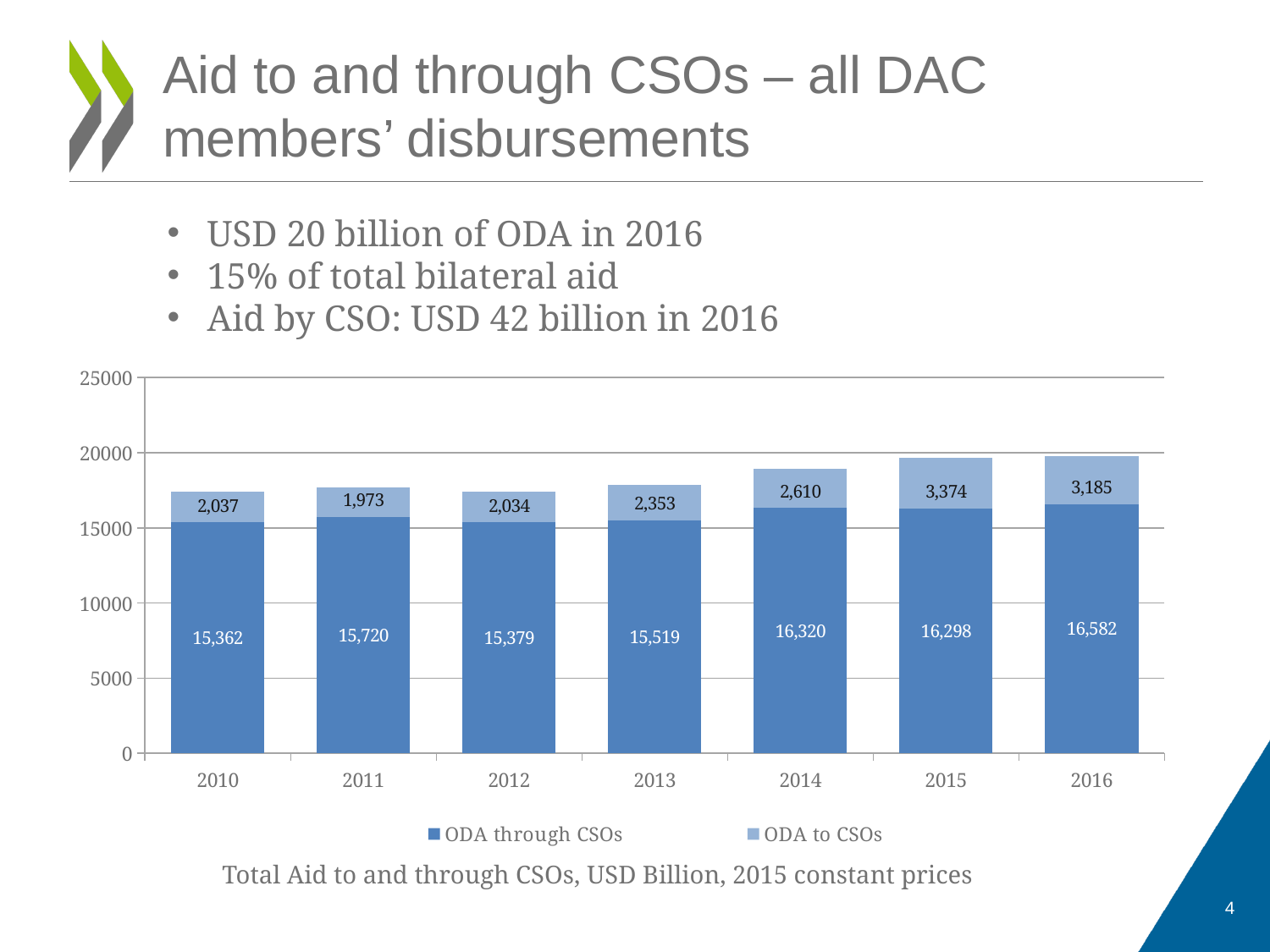
What is the total of the stacked bar for 2016? 19,767 Which is larger, ODA to CSOs in 2015 or in 2016? 2015 What is the difference between ODA through CSOs in 2016 and in 2010? 1,220 What is the value of ODA through CSOs in 2016? 16,582 How many series does the legend list? 2 What is the value of ODA to CSOs in 2013? 2,353 In which year is ODA to CSOs highest? 2015 What kind of chart is shown on the slide? Stacked bar chart In which year is ODA to CSOs lowest? 2011 In which year is ODA through CSOs lowest? 2010 Is the total stacked bar for 2010 greater or less than 20000? less How many years are shown on the x axis? 7